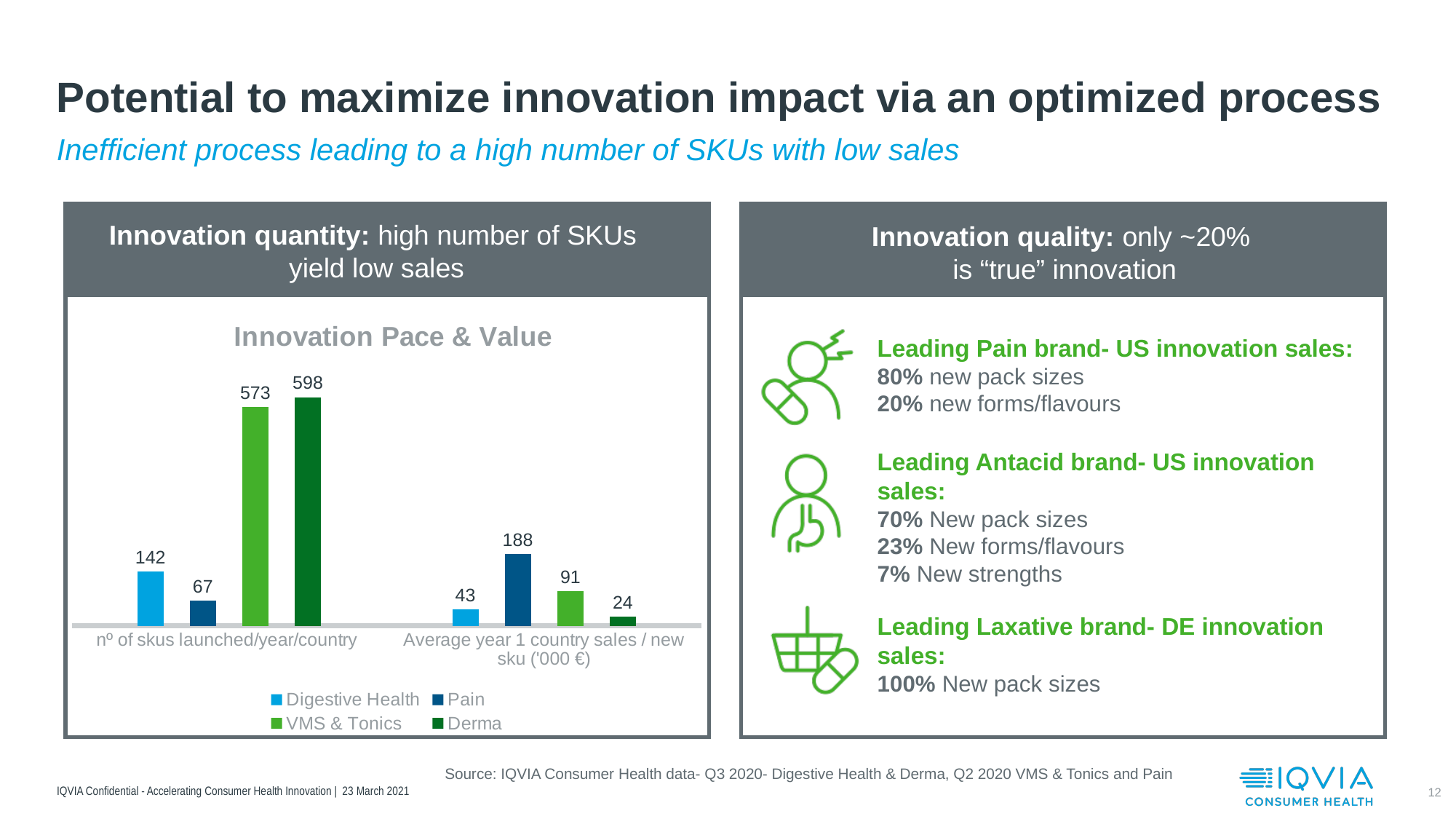
What is the difference between the Derma and VMS & Tonics values in the 'nº of skus launched/year/country' category? 25 Which series has the lowest value in the 'Average year 1 country sales / new sku ('000 €)' category? Derma How many series does the legend list? 4 What type of chart is shown? bar chart What is the chart title? Innovation Pace & Value What is the value for Digestive Health in the 'nº of skus launched/year/country' category? 142 What is the value for Derma in the 'nº of skus launched/year/country' category? 598 Which series has the highest value in the 'nº of skus launched/year/country' category? Derma What is the value for Pain in the 'Average year 1 country sales / new sku ('000 €)' category? 188 How many categories are shown on the x axis? 2 What is the difference between the Pain and Digestive Health values in the 'Average year 1 country sales / new sku ('000 €)' category? 145 Which is larger in the 'Average year 1 country sales / new sku ('000 €)' category: Pain or VMS & Tonics? Pain